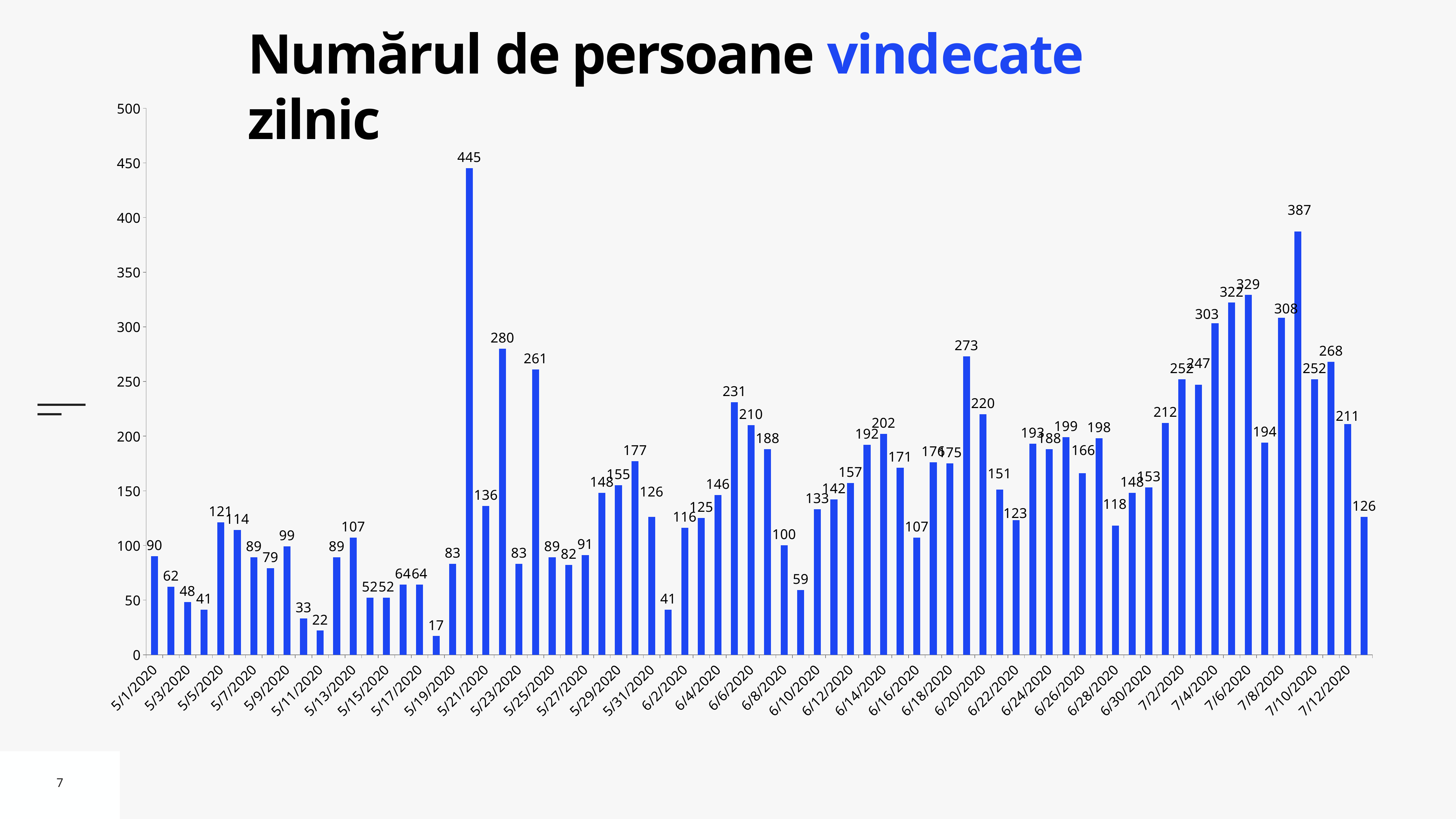
What is the difference between the values for 7/8/2020 and 7/12/2020? 97 What kind of chart is shown on the slide? bar chart Which is larger, the value for 5/5/2020 or the value for 5/13/2020? 5/5/2020 Is the value for 7/4/2020 greater or less than 300? greater What is the lowest daily value shown in the chart? 17 What is the value for 6/1/2020? 41 What is the highest daily value shown in the chart? 445 What is the value for 7/6/2020? 329 What is the value for 5/1/2020? 90 What colour are the bars in the chart? blue What is the value for 6/19/2020? 273 What is the title of the chart? Numărul de persoane vindecate zilnic